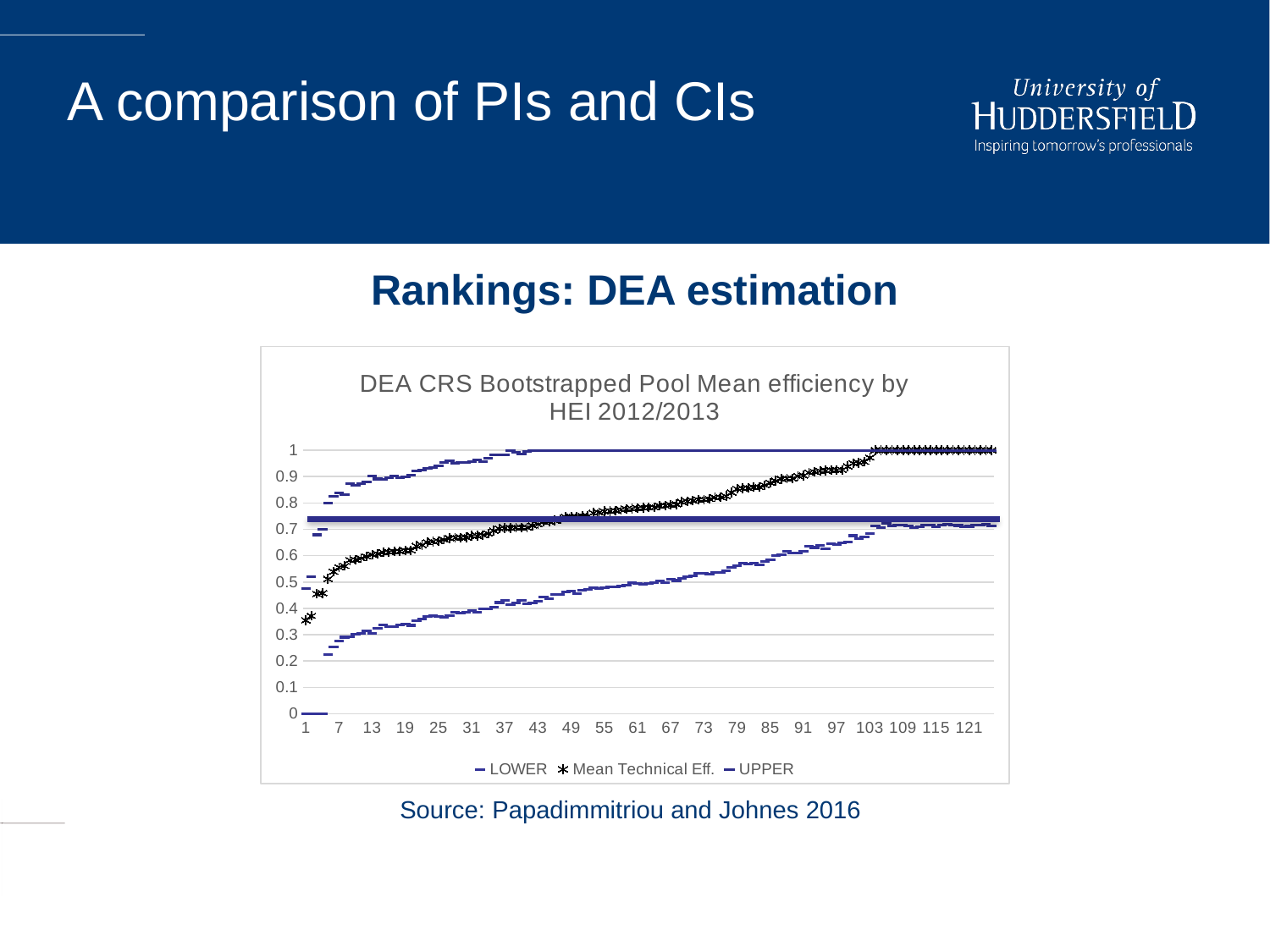
Is the value of the Mean Technical Eff. series at x = 61 greater or less than 0.7? greater At x = 61, which series has the larger value, UPPER or LOWER? UPPER Is the value of the LOWER series at x = 61 greater or less than 0.6? less Is the value of the UPPER series at x = 25 greater or less than 0.9? greater What kind of chart is shown on the slide? Line chart Do the values of the Mean Technical Eff. series rise or fall as the x axis increases? Rise What is the value of the UPPER series at x = 121? 1 What is the title of the chart? DEA CRS Bootstrapped Pool Mean efficiency by HEI 2012/2013 What is the value of the LOWER series at x = 1? 0 How many series does the legend of the chart list? 3 Which series are listed in the chart's legend? LOWER, Mean Technical Eff., UPPER